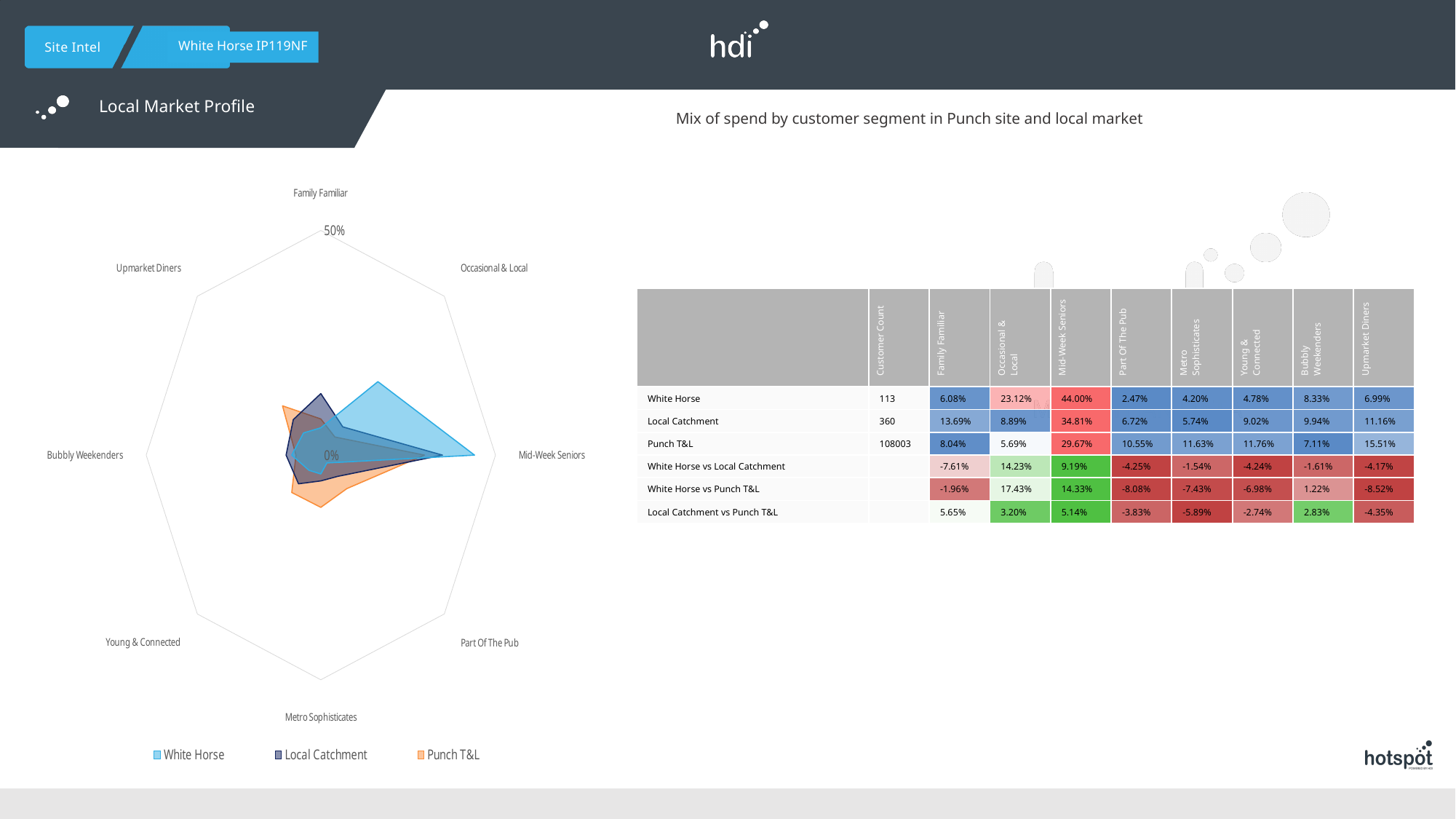
What are the three series named in the radar chart legend? White Horse, Local Catchment, Punch T&L Which customer segment has the highest value for White Horse? Mid-Week Seniors What is the difference between the White Horse and Local Catchment values for Occasional & Local? 14.23% For Mid-Week Seniors, which is larger: White Horse or Punch T&L? White Horse Which customer segment has the lowest value for Punch T&L? Occasional & Local What is the White Horse value for Mid-Week Seniors? 44.00% What is the Punch T&L value for Upmarket Diners? 15.51% How many customer segment categories are plotted on the radar chart? 8 What kind of chart is shown on the left of the slide? radar chart How many series does the legend of the radar chart list? 3 What is the Local Catchment value for Family Familiar? 13.69% Is the White Horse value for Mid-Week Seniors greater or less than 50%? less